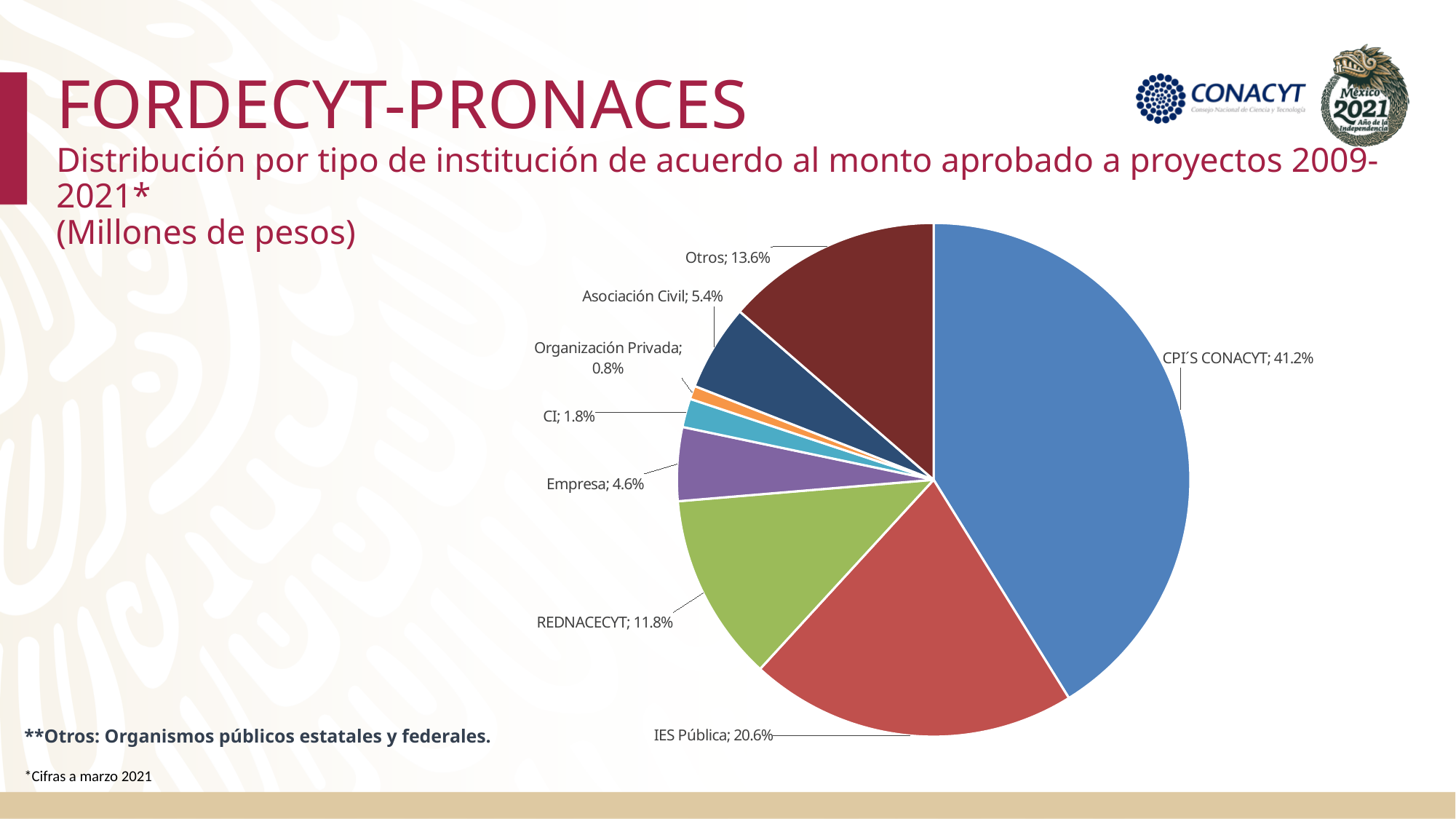
Which is larger, the share for Asociación Civil or the share for Empresa? Asociación Civil How many categories are shown in the pie chart? 8 What is the difference between the shares of IES Pública and REDNACECYT? 8.8% What is the value shown for IES Pública? 20.6% What kind of chart is shown on the slide? pie chart Which category has the smallest slice of the pie? Organización Privada What is the value shown for Organización Privada? 0.8% What share of the pie does CPI´S CONACYT hold? 41.2% What is the difference between the shares of Otros and CI? 11.8% What is the value shown for REDNACECYT? 11.8% Which category has the largest slice of the pie? CPI´S CONACYT What colour is the slice for Empresa? purple